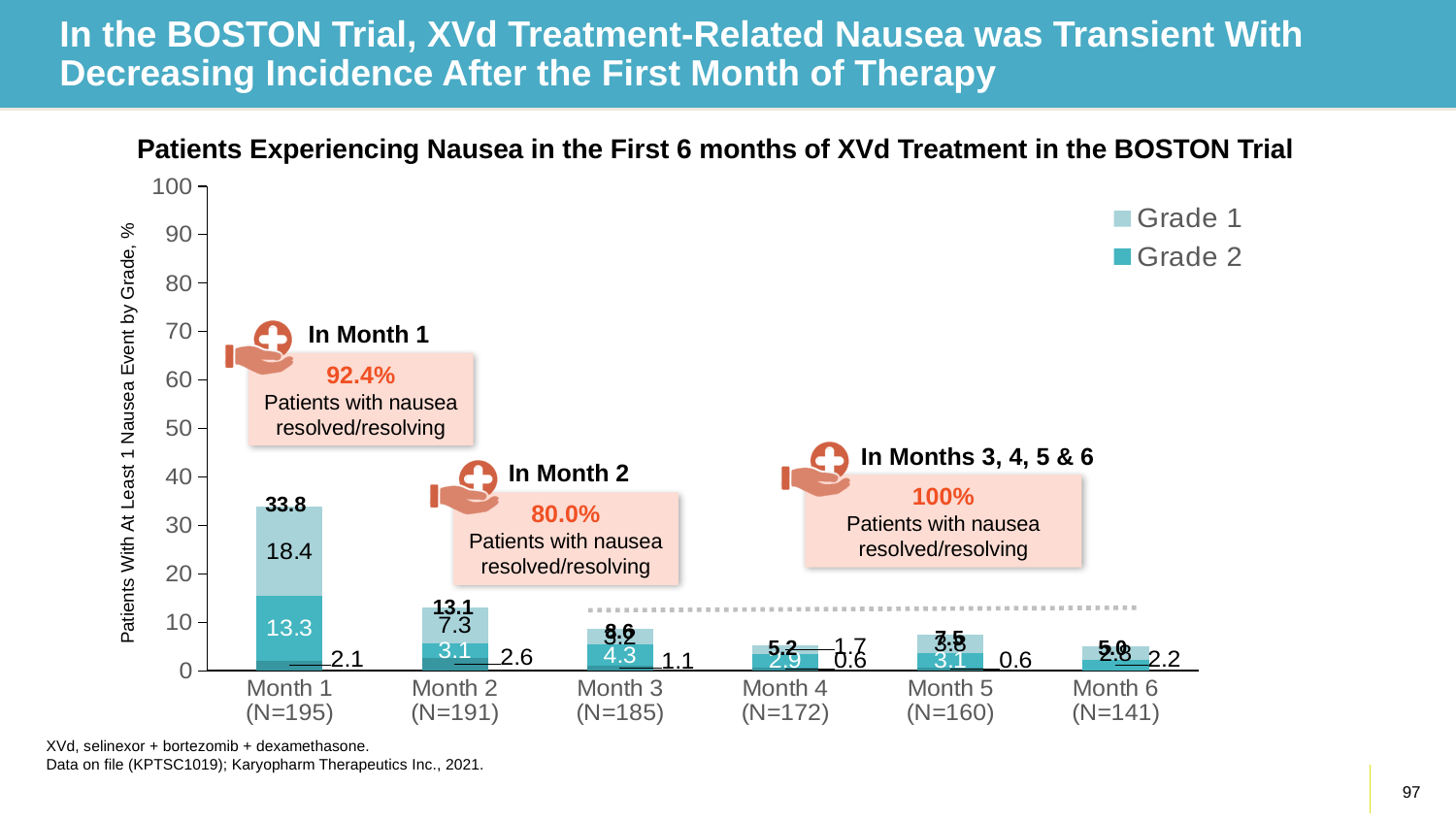
In Month 1, which is larger, the Grade 1 value or the Grade 2 value? Grade 1 What is the Grade 2 value for Month 1? 13.3 What is the difference between the total values for Month 1 and Month 2? 20.7 How many series does the legend list? 2 What is the Grade 1 value for Month 1? 18.4 What is the Grade 1 value for Month 2? 7.3 Which month has the highest total percentage of patients with a nausea event? Month 1 Is the total value for Month 1 greater or less than 30? greater How many months are shown on the x axis? 6 What is the total percentage of patients with at least 1 nausea event in Month 1? 33.8 Do the total values rise or fall from Month 1 to Month 6? fall What is the total percentage of patients with at least 1 nausea event in Month 2? 13.1